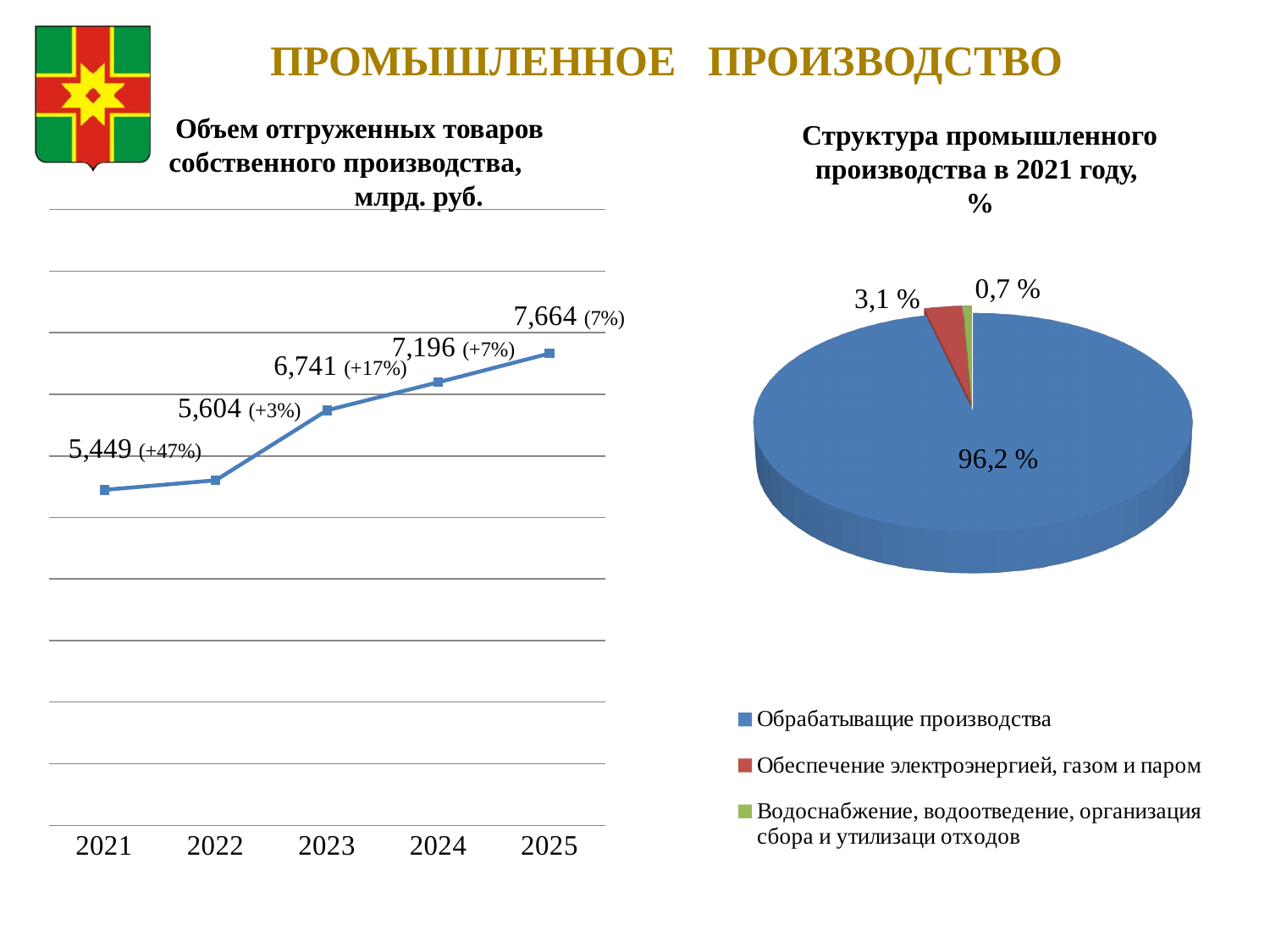
In the line chart 'Объем отгруженных товаров собственного производства, млрд. руб.', what is the difference between the 2024 and 2023 values? 0,455 What kind of chart is 'Структура промышленного производства в 2021 году, %'? pie chart How many entries does the legend of the pie chart 'Структура промышленного производства в 2021 году, %' list? 3 In the line chart 'Объем отгруженных товаров собственного производства, млрд. руб.', what is the value for 2025? 7,664 In the line chart 'Объем отгруженных товаров собственного производства, млрд. руб.', what is the value for 2023? 6,741 In the line chart 'Объем отгруженных товаров собственного производства, млрд. руб.', what percentage growth is shown next to the 2023 value? +17% In the line chart 'Объем отгруженных товаров собственного производства, млрд. руб.', how many years are plotted? 5 In the pie chart 'Структура промышленного производства в 2021 году, %', what share does 'Обеспечение электроэнергией, газом и паром' have? 3,1 % In the line chart 'Объем отгруженных товаров собственного производства, млрд. руб.', do the values rise or fall from 2021 to 2025? rise In the pie chart 'Структура промышленного производства в 2021 году, %', what share does 'Обрабатыващие производства' have? 96,2 % In the line chart 'Объем отгруженных товаров собственного производства, млрд. руб.', which year has the highest value? 2025 In the line chart 'Объем отгруженных товаров собственного производства, млрд. руб.', which year has the lowest value? 2021